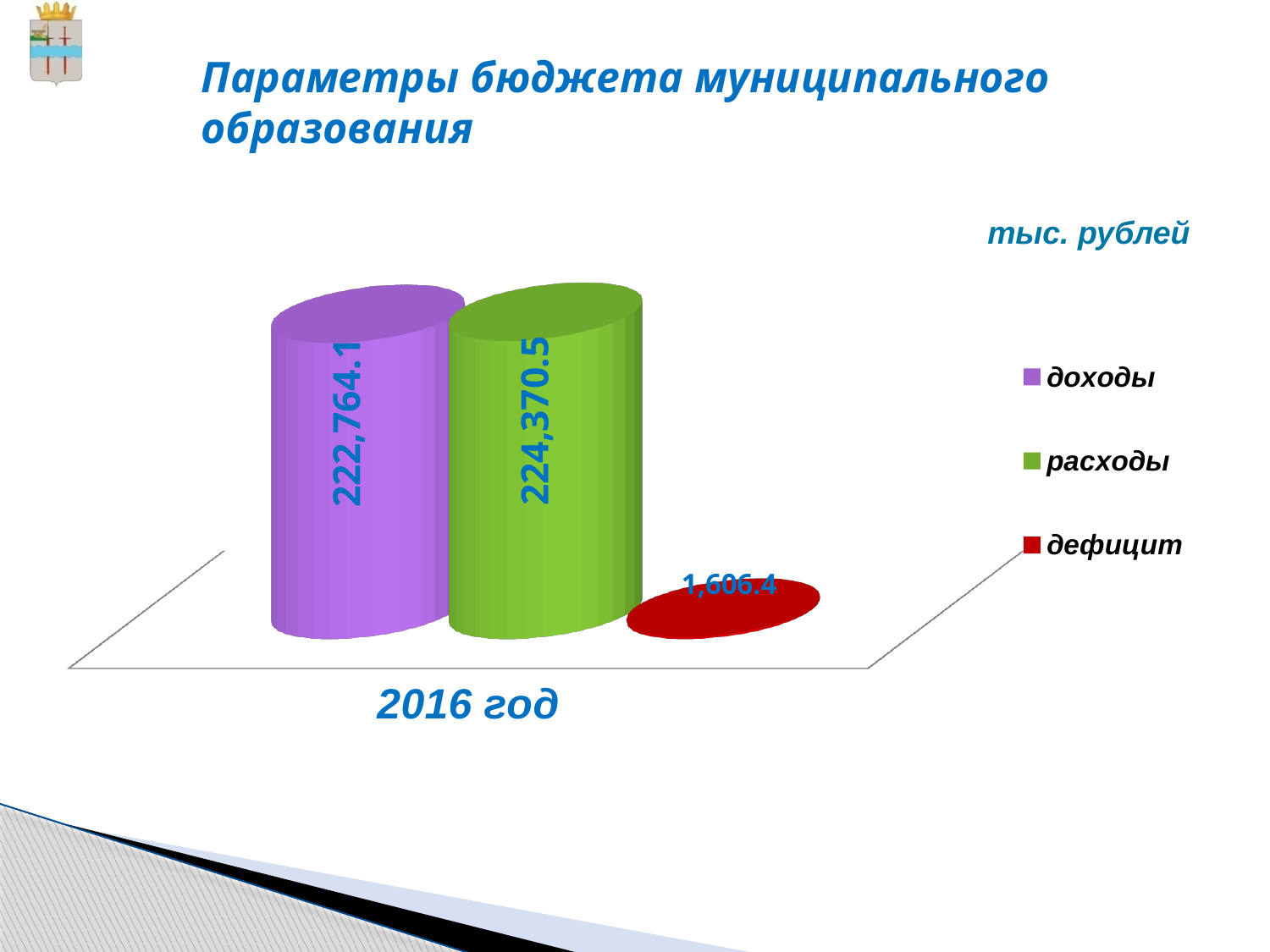
What is the value for расходы in 2016? 224,370.5 What colour represents дефицит in the legend? red Which series has the highest value on the chart? расходы What unit is stated for the values on the chart? тыс. рублей How many categories are shown on the x axis? 1 What is the value for дефицит in 2016? 1,606.4 Which series has the lowest value on the chart? дефицит What is the value for доходы in 2016? 222,764.1 Which is larger, доходы or расходы? расходы What kind of chart is shown on the slide? bar chart How many series does the legend list? 3 What is the difference between расходы and доходы? 1,606.4